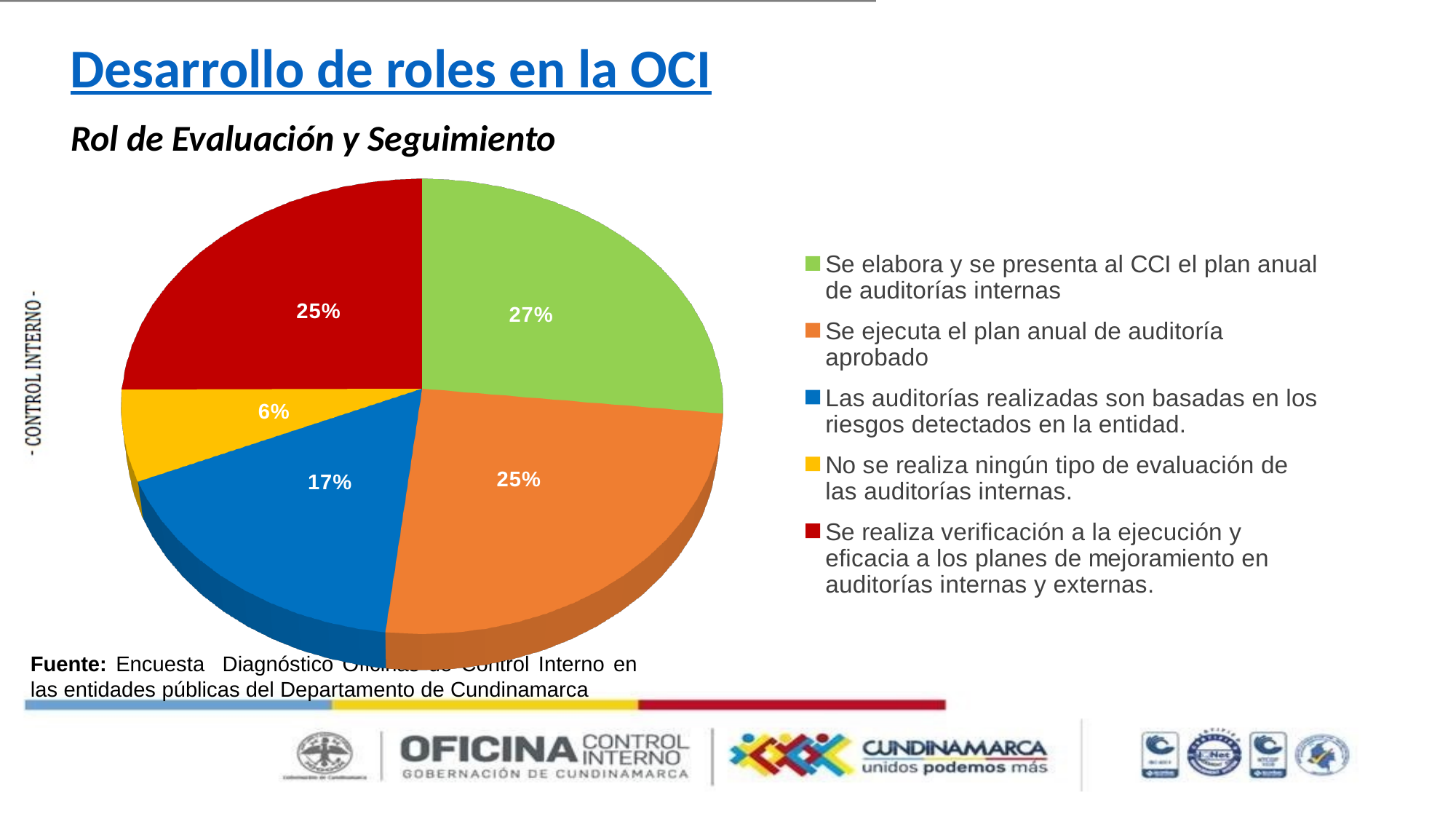
What percentage is shown for "Se elabora y se presenta al CCI el plan anual de auditorías internas"? 27% What percentage is shown for "Se ejecuta el plan anual de auditoría aprobado"? 25% What share of the pie does the red slice, "Se realiza verificación a la ejecución y eficacia a los planes de mejoramiento en auditorías internas y externas.", represent? 25% Which category has the smallest share of the pie? No se realiza ningún tipo de evaluación de las auditorías internas. What is the difference in percentage points between the largest slice (27%) and the slice for "Las auditorías realizadas son basadas en los riesgos detectados en la entidad."? 10 percentage points What percentage is shown for "Las auditorías realizadas son basadas en los riesgos detectados en la entidad."? 17% What type of chart is shown on the slide? Pie chart How many entries does the legend list? 5 How many slices does the pie chart have? 5 Which is larger: the share for "Se ejecuta el plan anual de auditoría aprobado" or the share for "No se realiza ningún tipo de evaluación de las auditorías internas."? Se ejecuta el plan anual de auditoría aprobado What percentage is shown for "No se realiza ningún tipo de evaluación de las auditorías internas."? 6% Which category has the largest share of the pie? Se elabora y se presenta al CCI el plan anual de auditorías internas